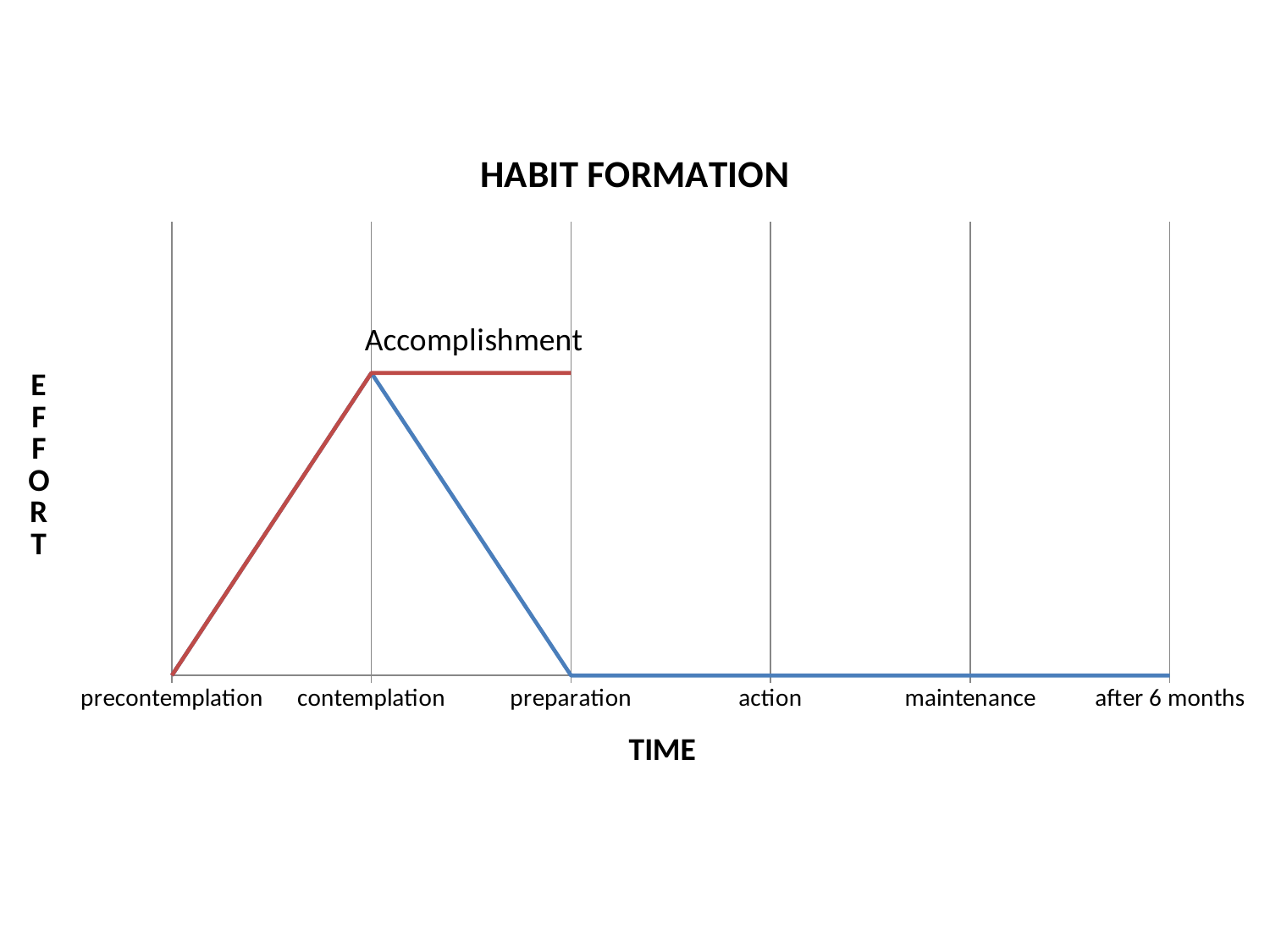
What is the title of the chart? HABIT FORMATION Which is the last category on the x axis? after 6 months Does the blue line rise, fall, or stay flat from preparation to after 6 months? stay flat Does the blue line rise or fall between contemplation and preparation? fall Does the red line rise or fall between precontemplation and contemplation? rise Which is the first category on the x axis? precontemplation Is the blue line higher at contemplation or at preparation? contemplation At which category does the blue line reach its highest point? contemplation What kind of chart is shown on the slide? line chart How many categories are shown along the x axis? 6 Is the blue line higher at contemplation or at action? contemplation